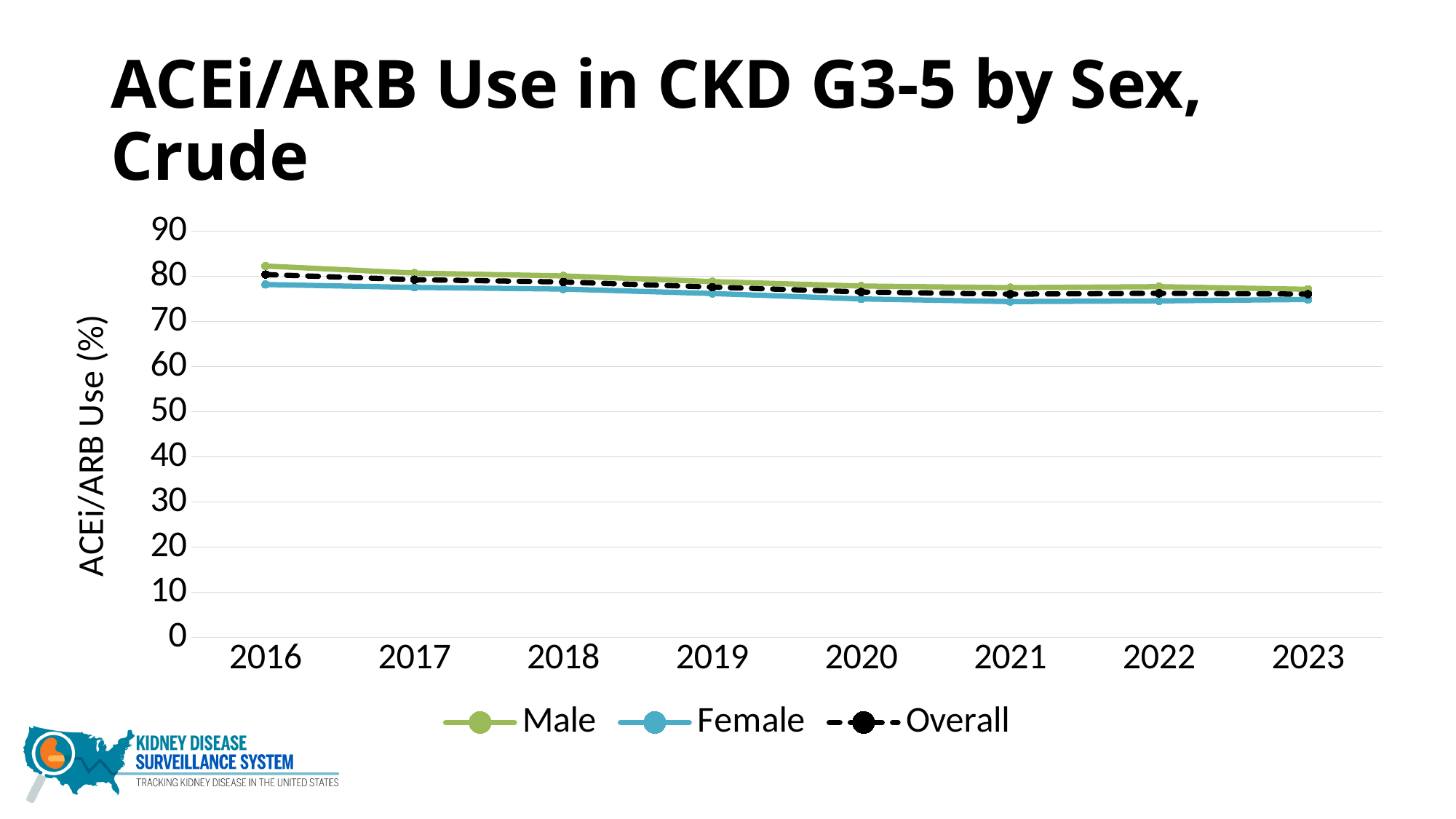
How many years are plotted along the x axis? 8 In 2023, is the value for Male greater or less than 70? greater Which series has the lowest value in 2016? Female How many series does the legend list? 3 Does the Male series rise or fall from 2016 to 2023? fall Which is larger in 2016, the value for Male or the value for Female? Male What kind of chart is shown on the slide? line chart Which series has the highest value in 2016? Male Which series is drawn with a dashed line? Overall In 2016, is the value for Female greater or less than 80? less In 2020, is the value for Overall greater or less than 80? less